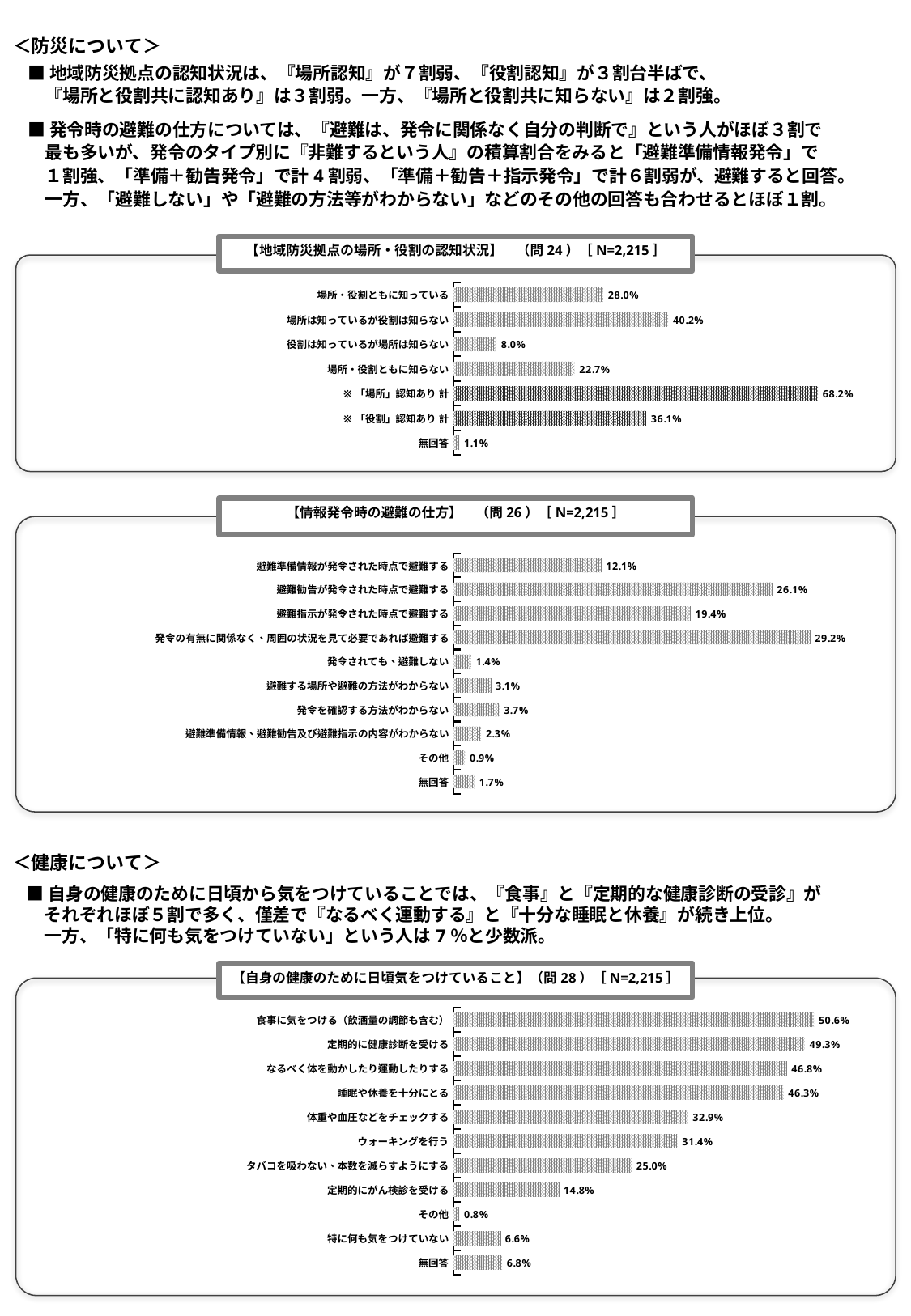
In the chart 【情報発令時の避難の仕方】(問26), which category has the highest value? 発令の有無に関係なく、周囲の状況を見て必要であれば避難する What sample size (N) is shown in the title of the chart 【自身の健康のために日頃気をつけていること】(問28)? N=2,215 In the chart 【自身の健康のために日頃気をつけていること】(問28), what is the value for 定期的にがん検診を受ける? 14.8% What type of chart is 【自身の健康のために日頃気をつけていること】(問28)? bar chart How many categories are shown in the chart 【情報発令時の避難の仕方】(問26)? 10 In the chart 【地域防災拠点の場所・役割の認知状況】(問24), which category has the lowest value? 無回答 In the chart 【地域防災拠点の場所・役割の認知状況】(問24), what is the value for 場所は知っているが役割は知らない? 40.2% In the chart 【情報発令時の避難の仕方】(問26), what is the value for 避難勧告が発令された時点で避難する? 26.1% In the chart 【情報発令時の避難の仕方】(問26), which is larger: 避難準備情報が発令された時点で避難する or 避難指示が発令された時点で避難する? 避難指示が発令された時点で避難する In the chart 【自身の健康のために日頃気をつけていること】(問28), what is the difference between 食事に気をつける（飲酒量の調節も含む） and 定期的に健康診断を受ける? 1.3% How many categories are shown in the chart 【地域防災拠点の場所・役割の認知状況】(問24)? 7 In the chart 【地域防災拠点の場所・役割の認知状況】(問24), what is the difference between ※「場所」認知あり 計 and ※「役割」認知あり 計? 32.1%